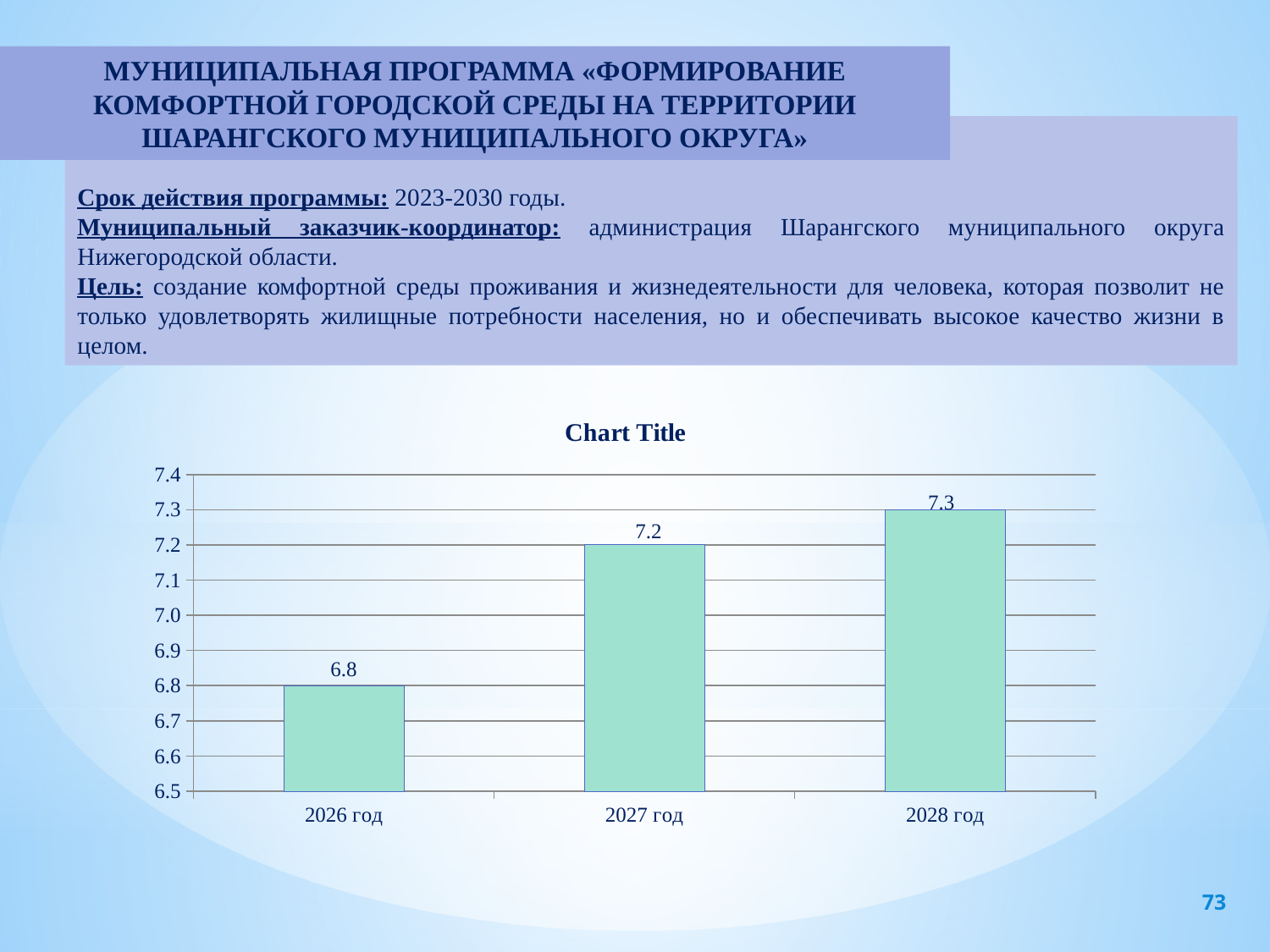
How many years are shown on the chart? 3 What is the difference between the values for 2028 год and 2026 год? 0.5 What kind of chart is shown on the slide? bar chart What is the difference between the values for 2027 год and 2026 год? 0.4 Which is larger, the value for 2026 год or the value for 2027 год? 2027 год What is the value for 2028 год? 7.3 What is the value for 2026 год? 6.8 Do the values rise or fall from 2026 год to 2028 год? rise Which year has the highest value? 2028 год Which year has the lowest value? 2026 год What is the value for 2027 год? 7.2 Is the value for 2026 год greater or less than 7.0? less